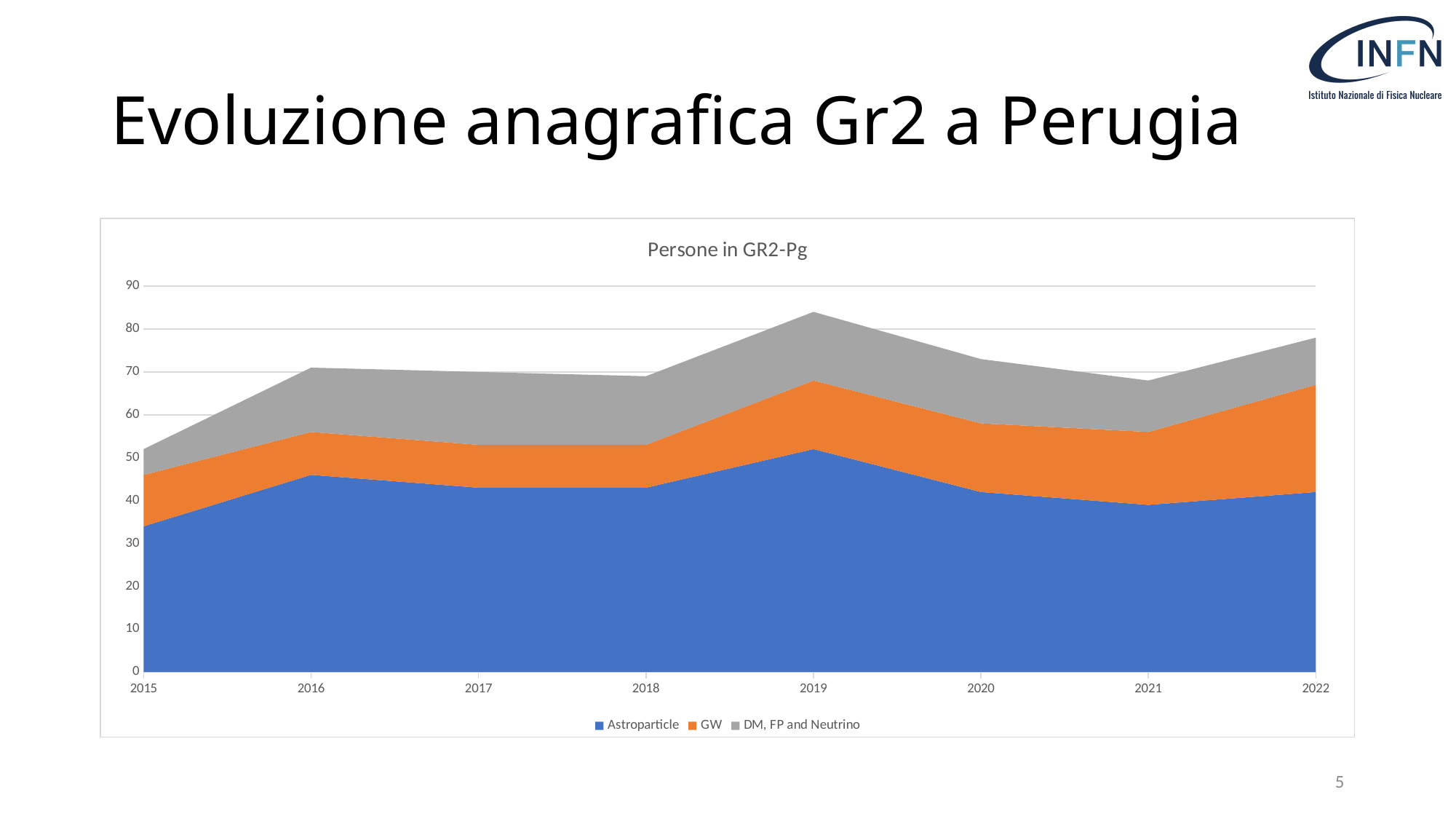
Does the Astroparticle series rise or fall from 2019 to 2021? fall Which year has a larger total, 2019 or 2021? 2019 Is the total value for 2015 greater or less than 60? less Is the total value for 2019 greater or less than 80? greater How many years are shown on the x axis? 8 What kind of chart is shown on the slide? stacked area chart In which year is the total number of people highest? 2019 In which year is the total number of people lowest? 2015 What is the title of the chart? Persone in GR2-Pg Which series is shown in orange in the legend? GW Is the Astroparticle value for 2015 greater or less than 40? less How many series does the legend list? 3